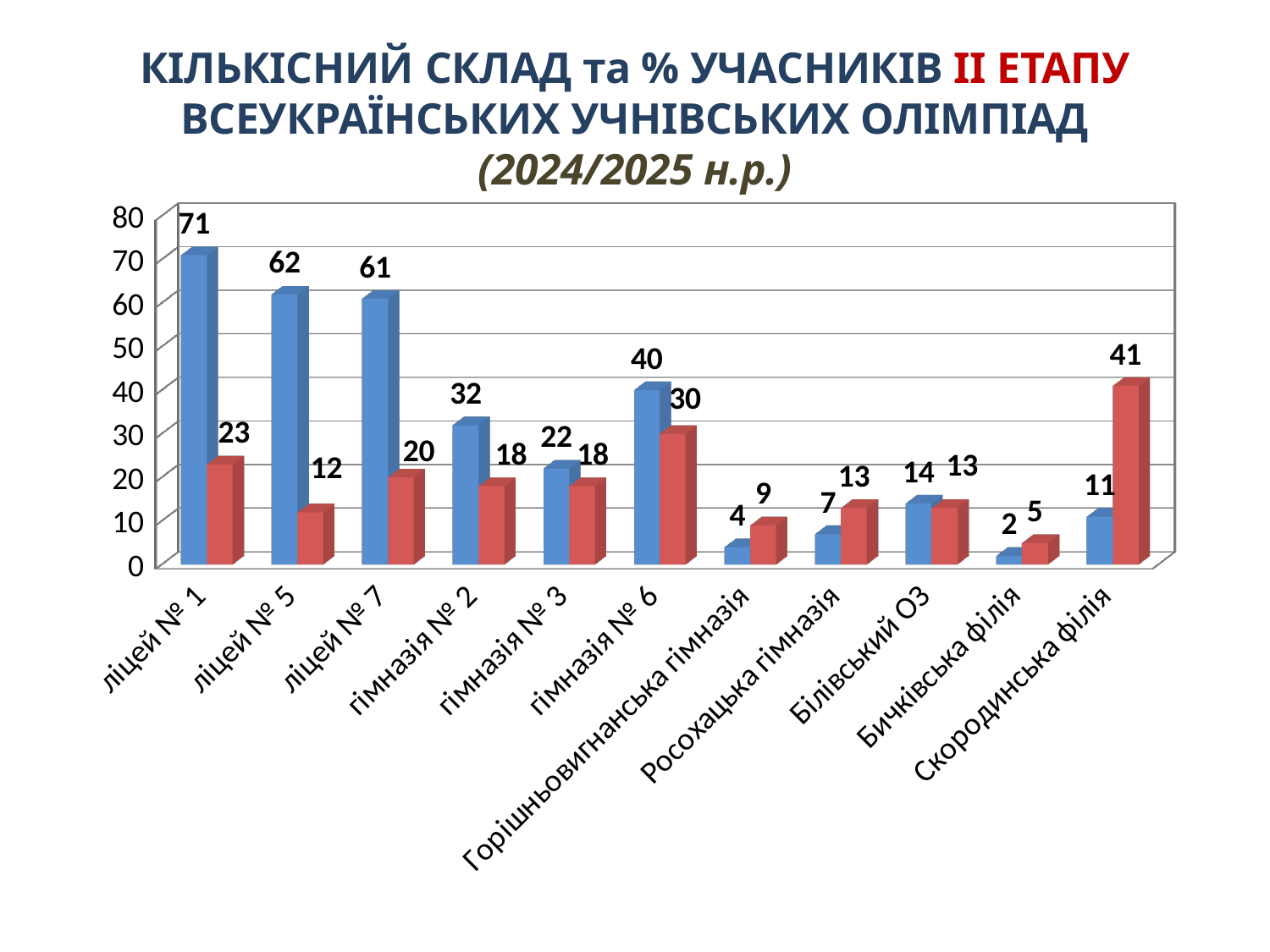
What is the value of the blue bar for ліцей № 1? 71 What is the difference between the blue bars for ліцей № 7 and гімназія № 2? 29 What school year is given in the chart title? 2024/2025 н.р. How many categories are shown on the x axis? 11 Which category has the highest red bar? Скородинська філія Which category has the lowest blue bar? Бичківська філія Which category has the highest blue bar? ліцей № 1 Which is larger for Росохацька гімназія, the blue bar or the red bar? the red bar What kind of chart is shown on the slide? bar chart What is the value of the red bar for Скородинська філія? 41 What is the difference between the blue and red bars for ліцей № 5? 50 What is the value of the red bar for гімназія № 6? 30